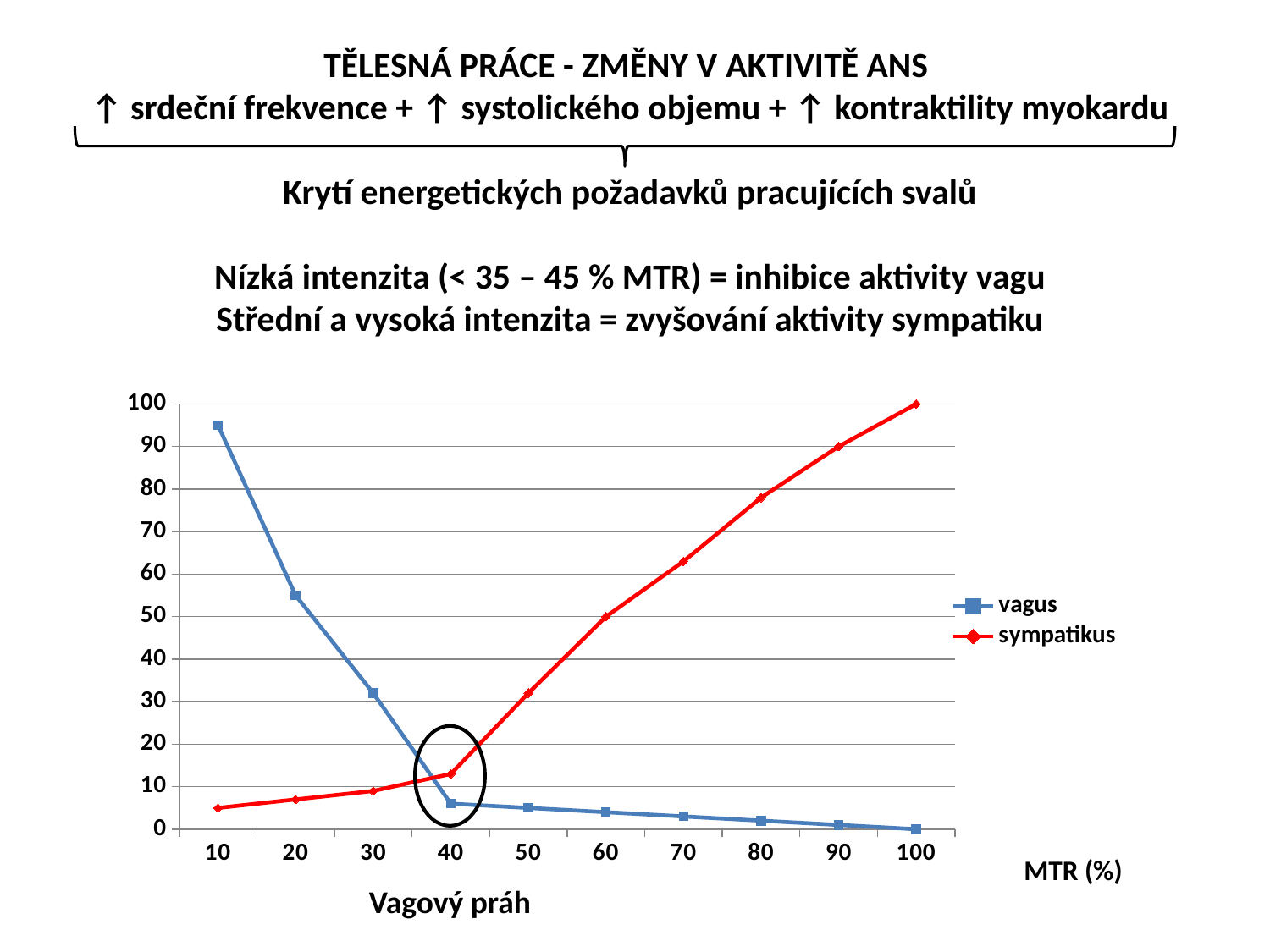
How many series does the chart legend list? 2 What is the value of vagus at 100 % MTR? 0 Does the sympatikus series rise or fall as MTR (%) increases? rise How many points along the MTR (%) axis does each series have? 10 Which two series are listed in the chart legend? vagus and sympatikus What kind of chart is shown on the slide? line chart Does the vagus series rise or fall as MTR (%) increases? fall At 80 % MTR, which series has the larger value, vagus or sympatikus? sympatikus At 20 % MTR, which series has the larger value, vagus or sympatikus? vagus Is the value of vagus at 10 % MTR greater or less than 90? greater What is the value of sympatikus at 100 % MTR? 100 Is the value of sympatikus at 80 % MTR greater or less than 70? greater